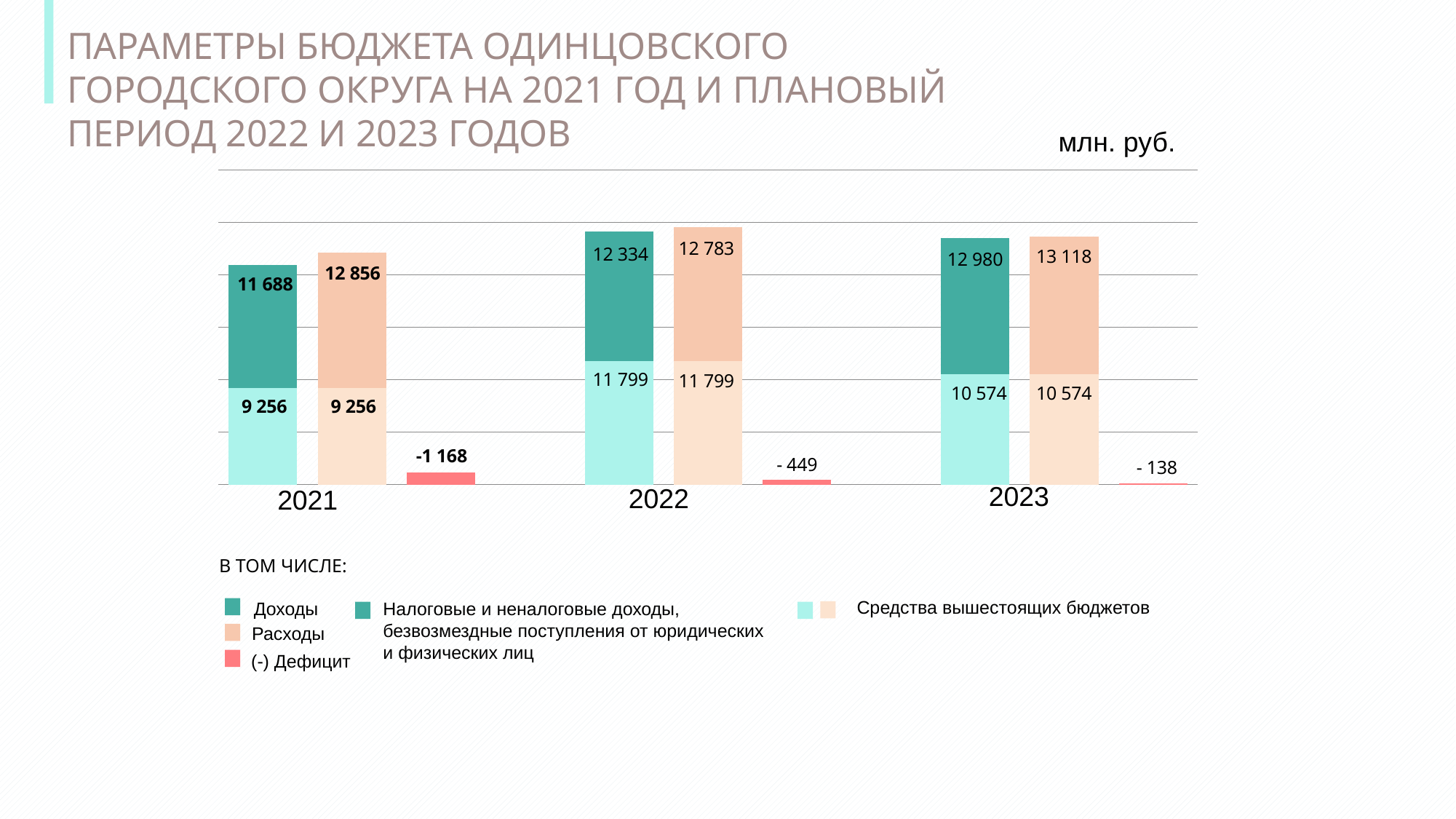
Which is larger: the Средства вышестоящих бюджетов segment for 2022 or for 2023? 2022 How many years are shown on the x axis of the chart? 3 What is the value of the Средства вышестоящих бюджетов segment of the Расходы bar for 2022? 11 799 How does the absolute value of the deficit change from 2021 to 2023? It falls What is the total of the stacked Доходы bar for 2021? 20 944 What is the total of the stacked Расходы bar for 2022? 24 582 What is the value of the upper segment of the Расходы bar for 2023? 13 118 In which year is the deficit (Дефицит) largest in absolute value? 2021 What is the value of the tax and non-tax income segment (Налоговые и неналоговые доходы) of the Доходы bar for 2021? 11 688 What is the deficit (Дефицит) value shown for 2023? - 138 What is the difference between the upper segments of the Расходы and Доходы bars for 2023 (13 118 and 12 980)? 138 What unit of measurement is indicated for the chart values? млн. руб.